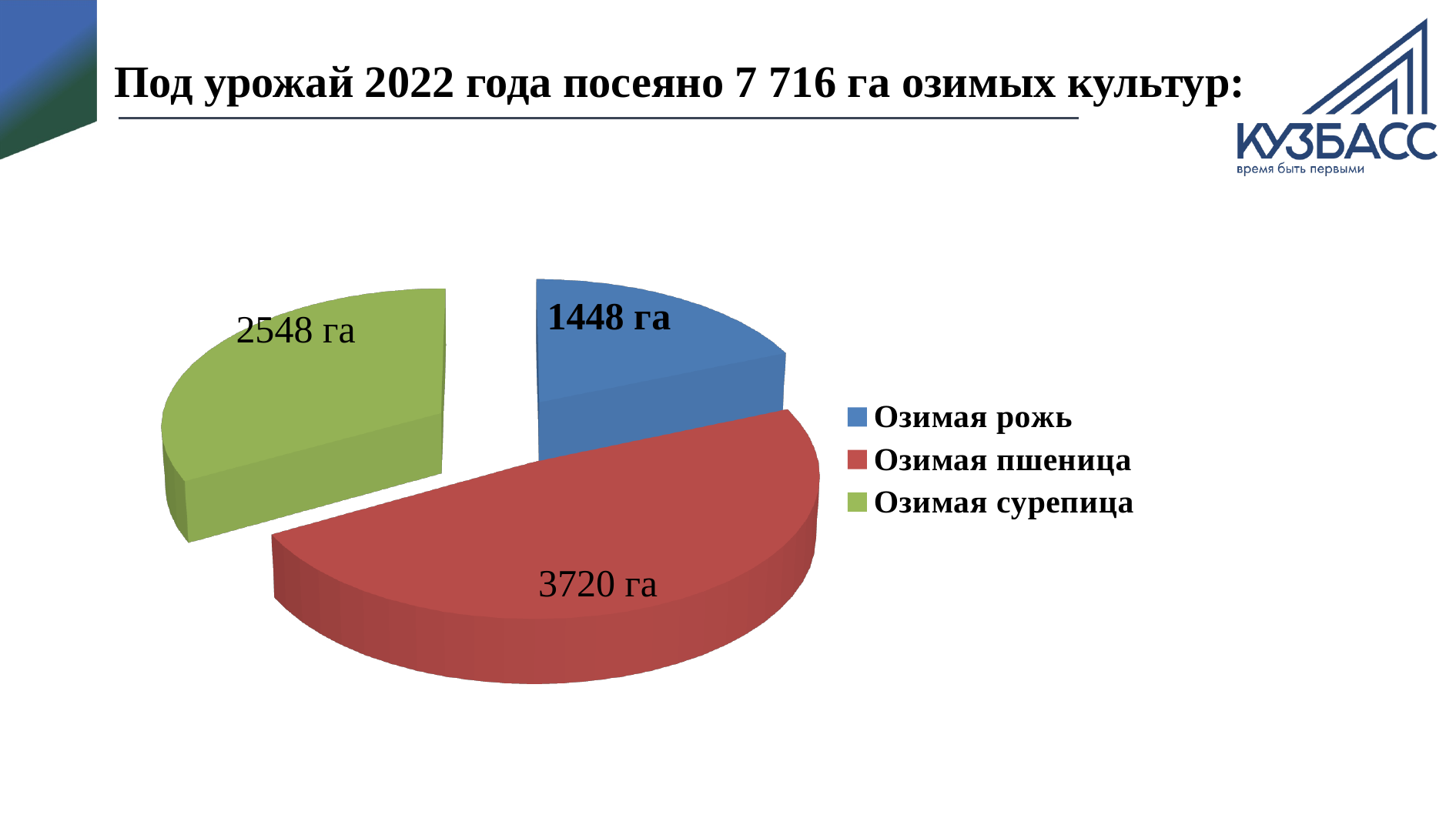
What is the difference between the areas of Озимая пшеница and Озимая сурепица? 1172 га What is the value for Озимая рожь? 1448 га How many entries does the legend list? 3 Which crop has the smallest sown area? Озимая рожь What is the total area of all three slices combined? 7 716 га Which crop has the largest sown area? Озимая пшеница Which colour represents Озимая сурепица in the chart? Green What is the value for Озимая пшеница? 3720 га What is the value for Озимая сурепица? 2548 га How many slices does the pie chart have? 3 What kind of chart is shown on the slide? Pie chart Which is larger, the area of Озимая сурепица or Озимая рожь? Озимая сурепица